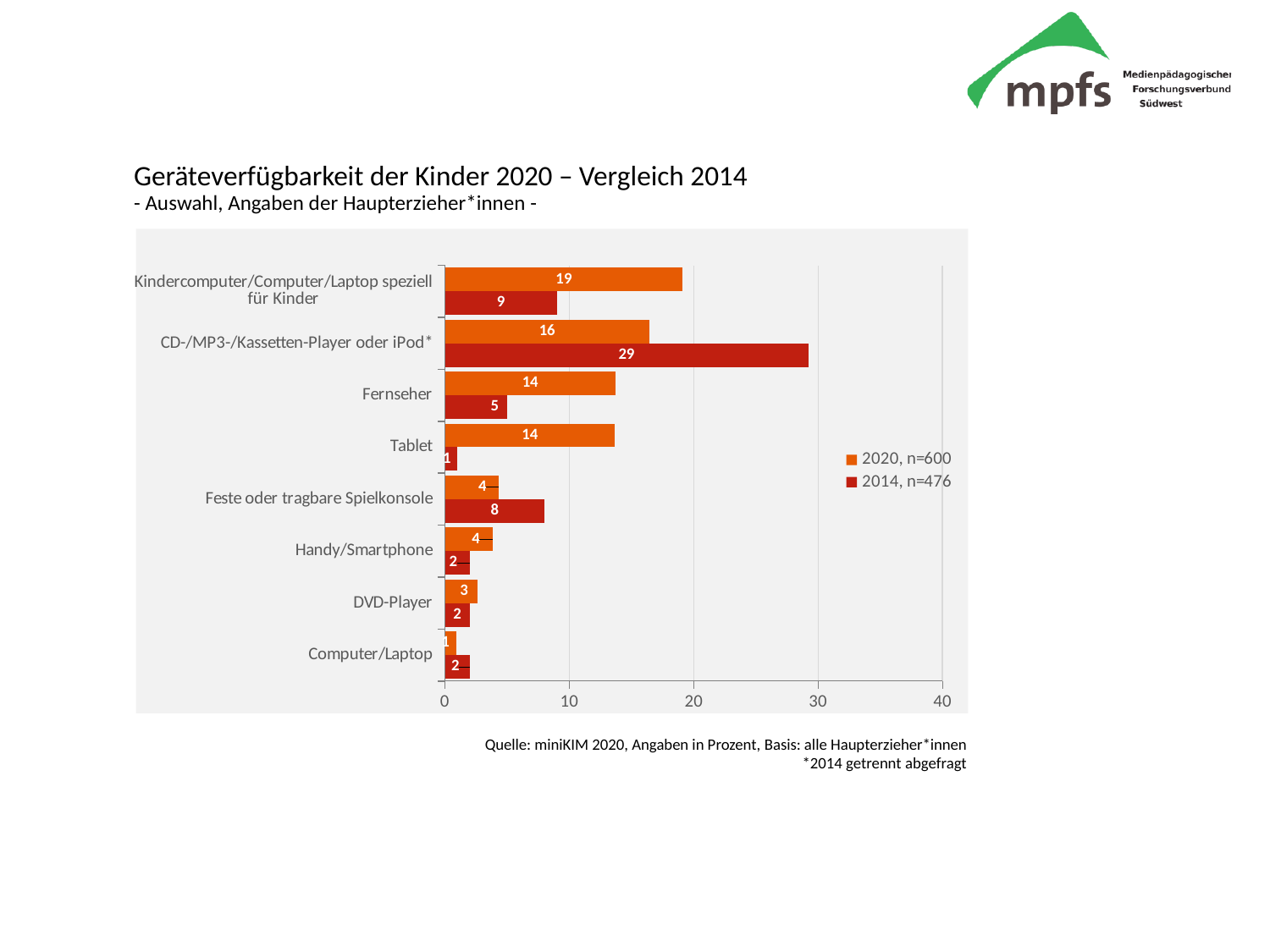
What kind of chart is shown on the slide? Bar chart What is the difference between the 2014 and 2020 values for CD-/MP3-/Kassetten-Player oder iPod*? 13 For Feste oder tragbare Spielkonsole, which is larger: the 2020 value or the 2014 value? 2014 Is the 2014 value for CD-/MP3-/Kassetten-Player oder iPod* greater or less than 20? greater What is the 2014 value for CD-/MP3-/Kassetten-Player oder iPod*? 29 What is the 2020 value for Fernseher? 14 What is the sample size (n) given in the legend for the 2014 series? n=476 Which category has the highest 2020 value? Kindercomputer/Computer/Laptop speziell für Kinder How many device categories are shown in the chart? 8 What is the 2014 value for Tablet? 1 How many series does the legend list? 2 Which category has the lowest 2020 value? Computer/Laptop